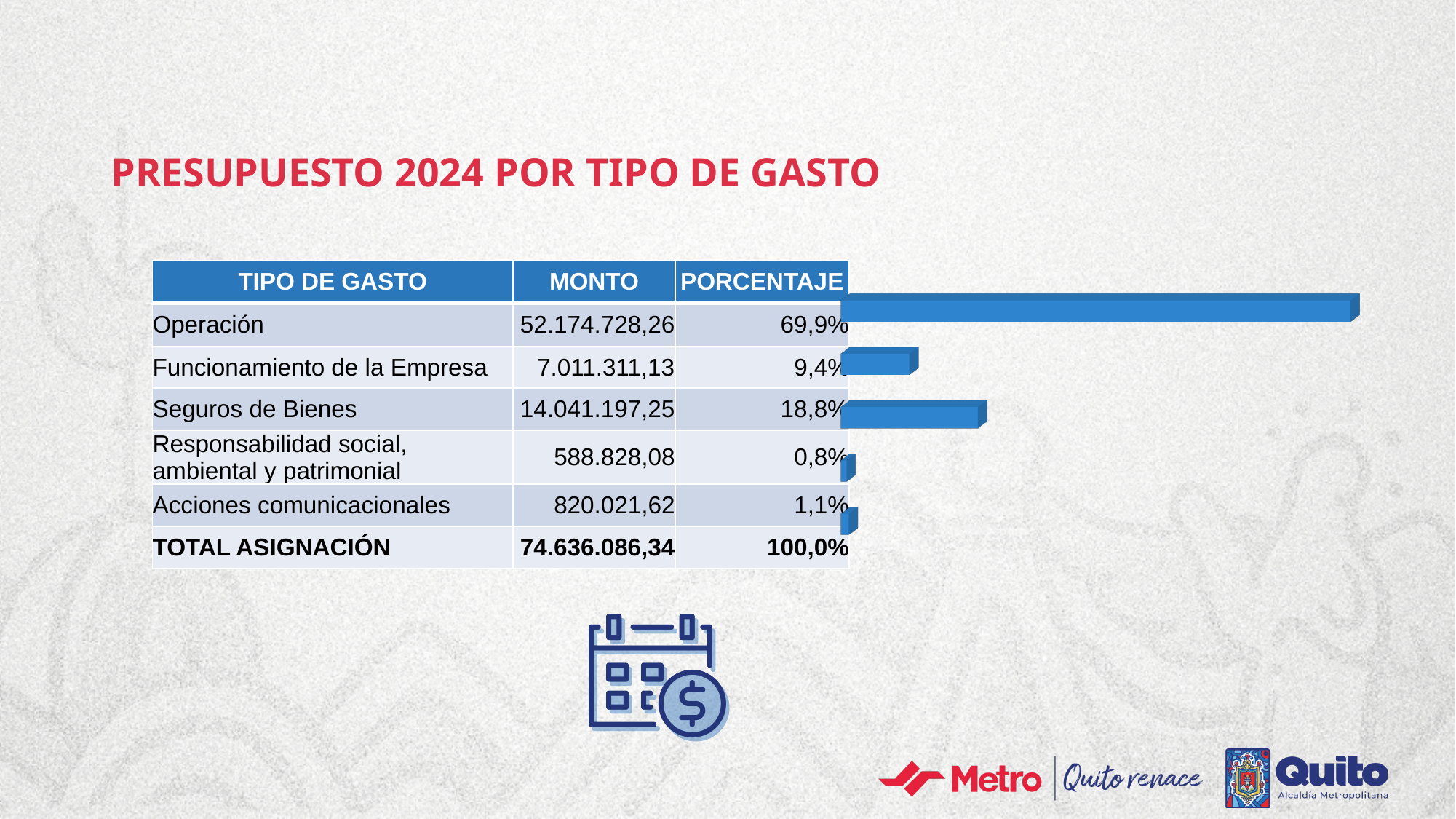
What is the difference in porcentaje between Seguros de Bienes and Funcionamiento de la Empresa? 9,4% What is the porcentaje for Funcionamiento de la Empresa? 9,4% What is the porcentaje for Operación? 69,9% What is the title of the slide containing the chart? PRESUPUESTO 2024 POR TIPO DE GASTO What is the monto for Seguros de Bienes? 14.041.197,25 What is the monto for Acciones comunicacionales? 820.021,62 What is the total asignación shown on the slide? 74.636.086,34 Which tipo de gasto has the shortest bar in the chart? Responsabilidad social, ambiental y patrimonial Which tipo de gasto has the longest bar in the chart? Operación Which has a larger bar, Seguros de Bienes or Funcionamiento de la Empresa? Seguros de Bienes How many bars does the chart show? 5 What kind of chart is shown next to the table on the slide? Bar chart